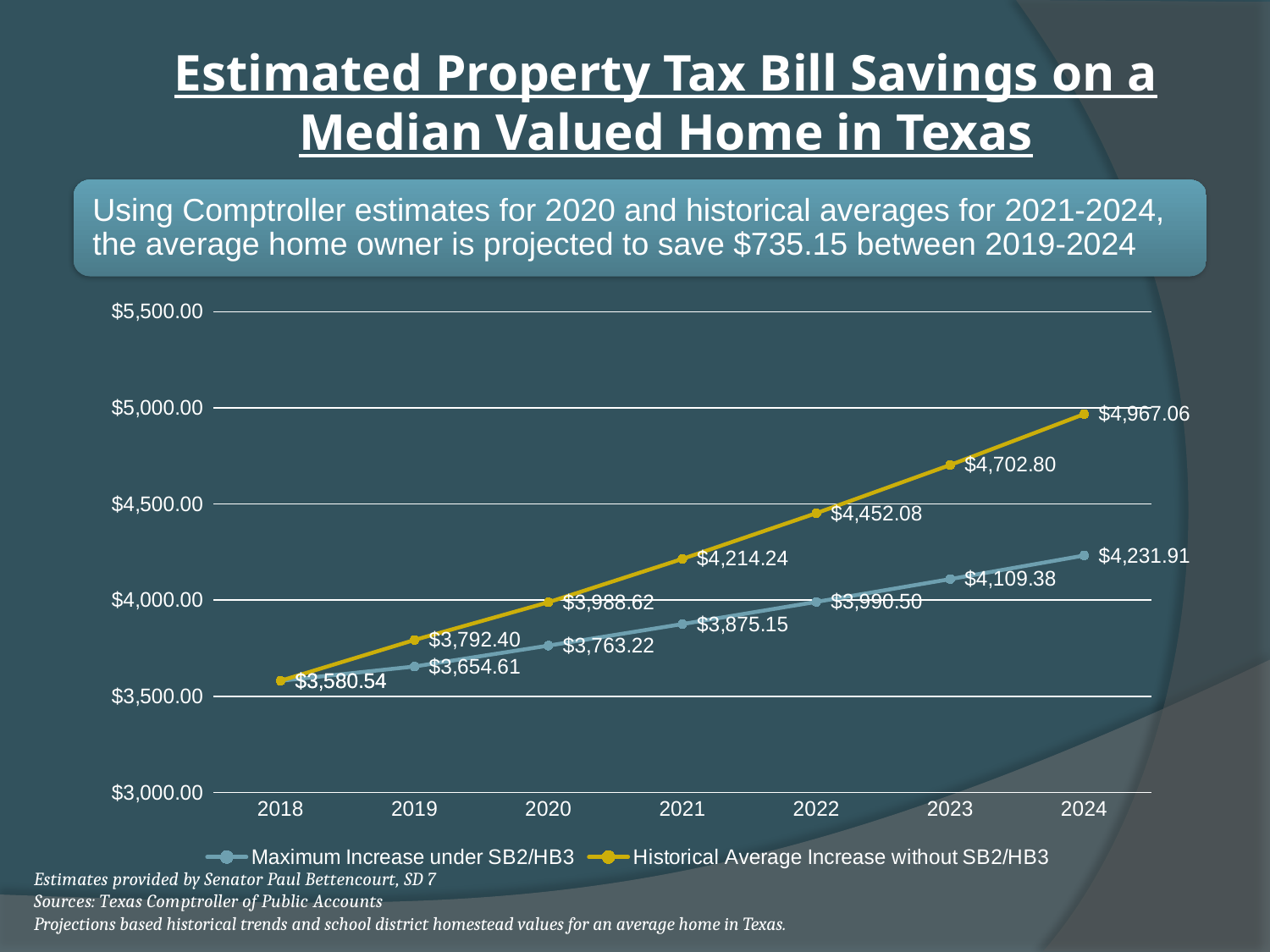
What is the value for Maximum Increase under SB2/HB3 in 2024? $4,231.91 What is the value for Maximum Increase under SB2/HB3 in 2021? $3,875.15 Is the value for Historical Average Increase without SB2/HB3 in 2023 greater or less than $4,500.00? greater What is the value for Historical Average Increase without SB2/HB3 in 2024? $4,967.06 Which series has the higher value in 2022? Historical Average Increase without SB2/HB3 What type of chart is shown on the slide? Line chart What is the difference between the two series in 2023? $593.42 What is the value for Historical Average Increase without SB2/HB3 in 2022? $4,452.08 What is the difference between the two series in 2024? $735.15 Do the values for Maximum Increase under SB2/HB3 rise or fall from 2018 to 2024? Rise How many years are plotted along the x axis? 7 How many series does the legend list? 2